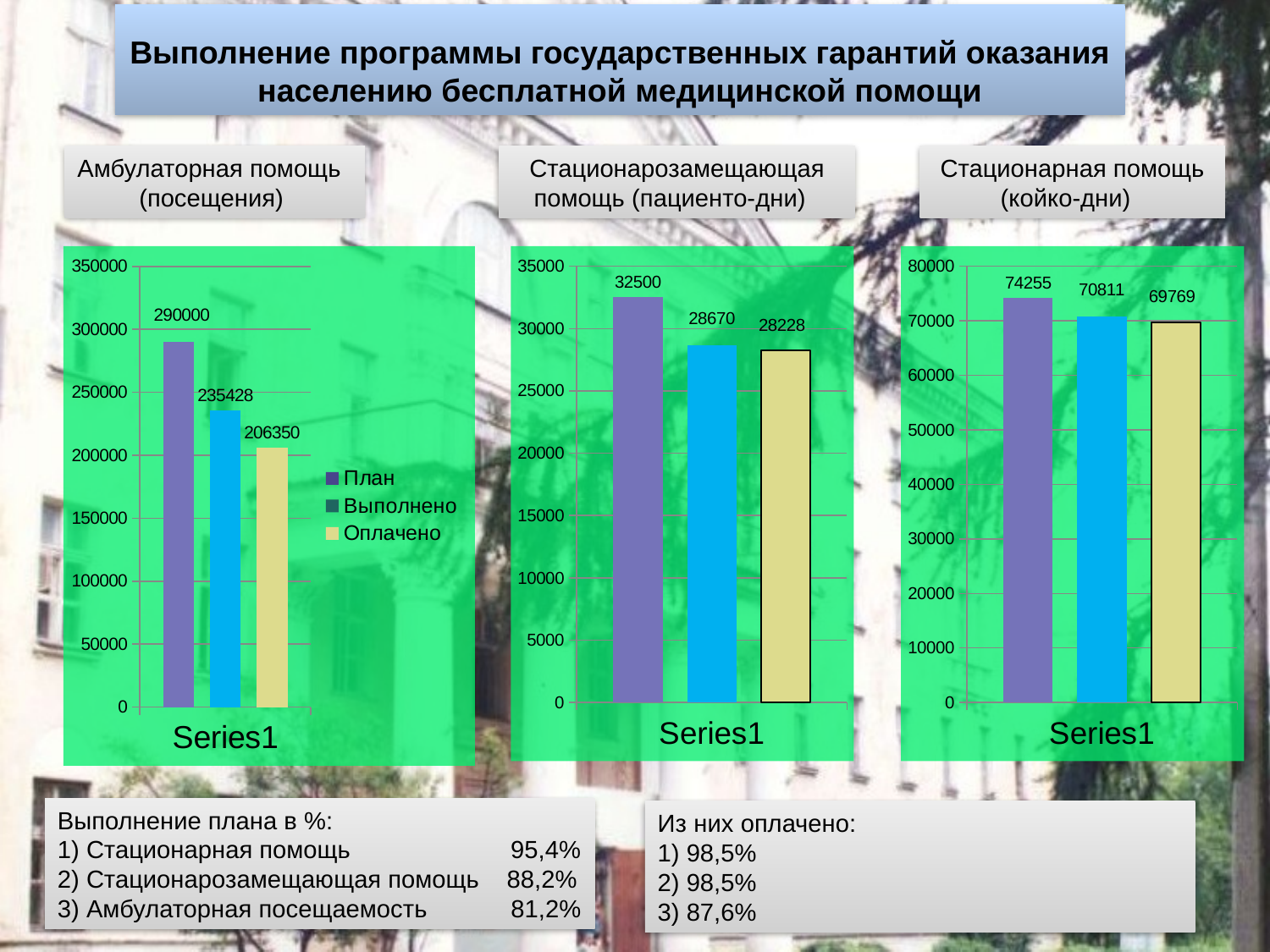
How many series does the legend of the chart titled 'Амбулаторная помощь (посещения)' list? 3 In the chart titled 'Стационарная помощь (койко-дни)', what is the value of the second (blue) bar? 70811 In the chart titled 'Стационарозамещающая помощь (пациенто-дни)', what is the value of the third (yellow) bar? 28228 In the chart titled 'Амбулаторная помощь (посещения)', what is the difference between the План and Выполнено values? 54572 In the chart titled 'Стационарозамещающая помощь (пациенто-дни)', what is the value of the first (purple) bar? 32500 In the chart titled 'Амбулаторная помощь (посещения)', what is the value of the План bar? 290000 In the chart titled 'Стационарная помощь (койко-дни)', which bar has the highest value? The first (purple) bar, 74255 In the chart titled 'Стационарная помощь (койко-дни)', what is the difference between the first (purple) bar and the third (yellow) bar? 4486 In the chart titled 'Амбулаторная помощь (посещения)', what is the value of the Оплачено bar? 206350 In the chart titled 'Амбулаторная помощь (посещения)', do the values rise or fall from the План bar to the Оплачено bar? Fall What type of chart is the chart titled 'Стационарная помощь (койко-дни)'? Bar chart In the chart titled 'Стационарозамещающая помощь (пациенто-дни)', which bar has the lowest value? The third (yellow) bar, 28228